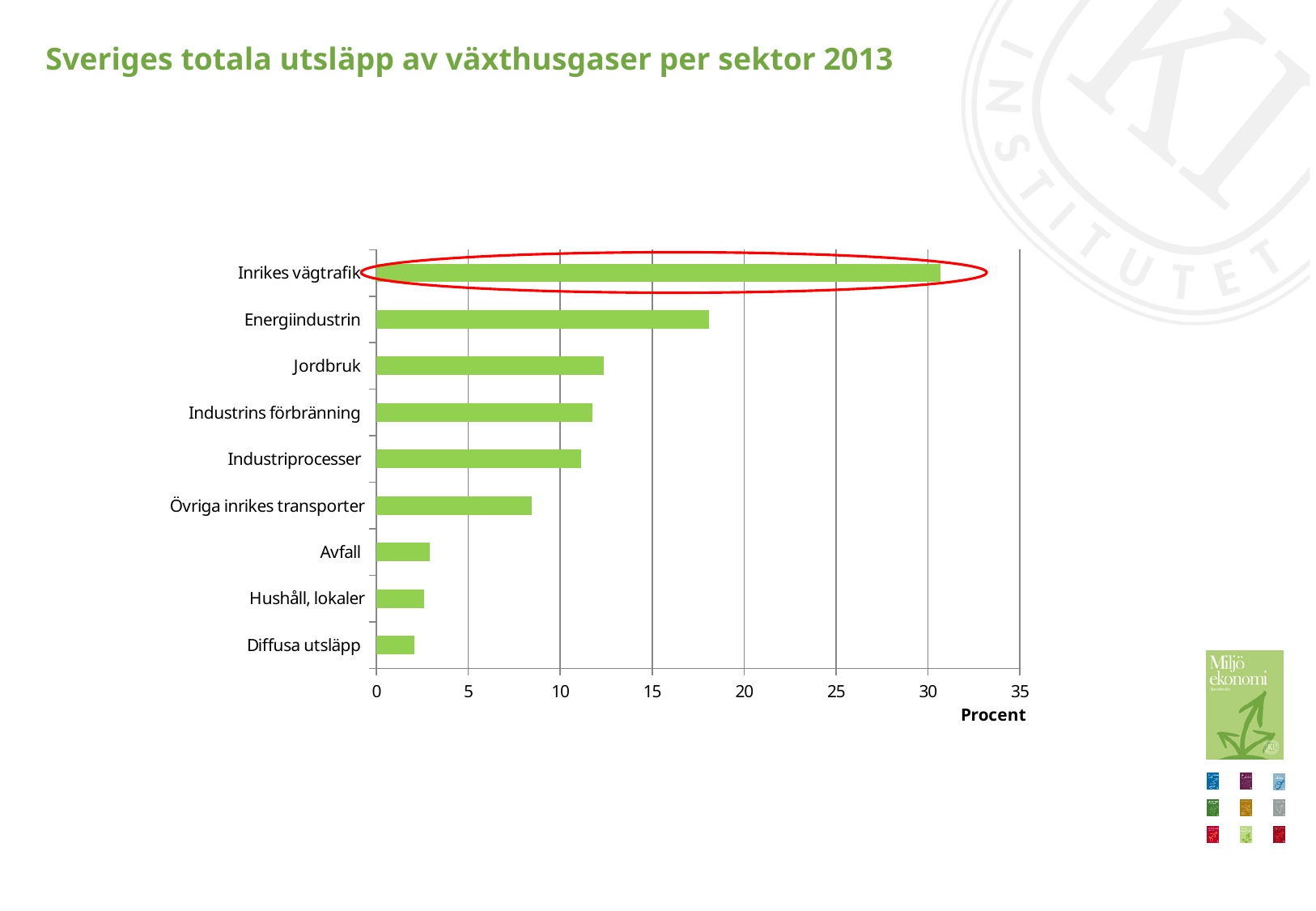
Is the value for Avfall greater or less than 5? less Is the value for Jordbruk greater or less than 10? greater Which sector has the highest share of emissions? Inrikes vägtrafik How many sectors are shown in the chart? 9 Which is larger, the value for Energiindustrin or the value for Jordbruk? Energiindustrin Which bar is circled in red on the chart? Inrikes vägtrafik Is the value for Energiindustrin greater or less than 15? greater What is the label on the horizontal axis? Procent What kind of chart is shown on the slide? Bar chart Which is larger, the value for Övriga inrikes transporter or the value for Avfall? Övriga inrikes transporter